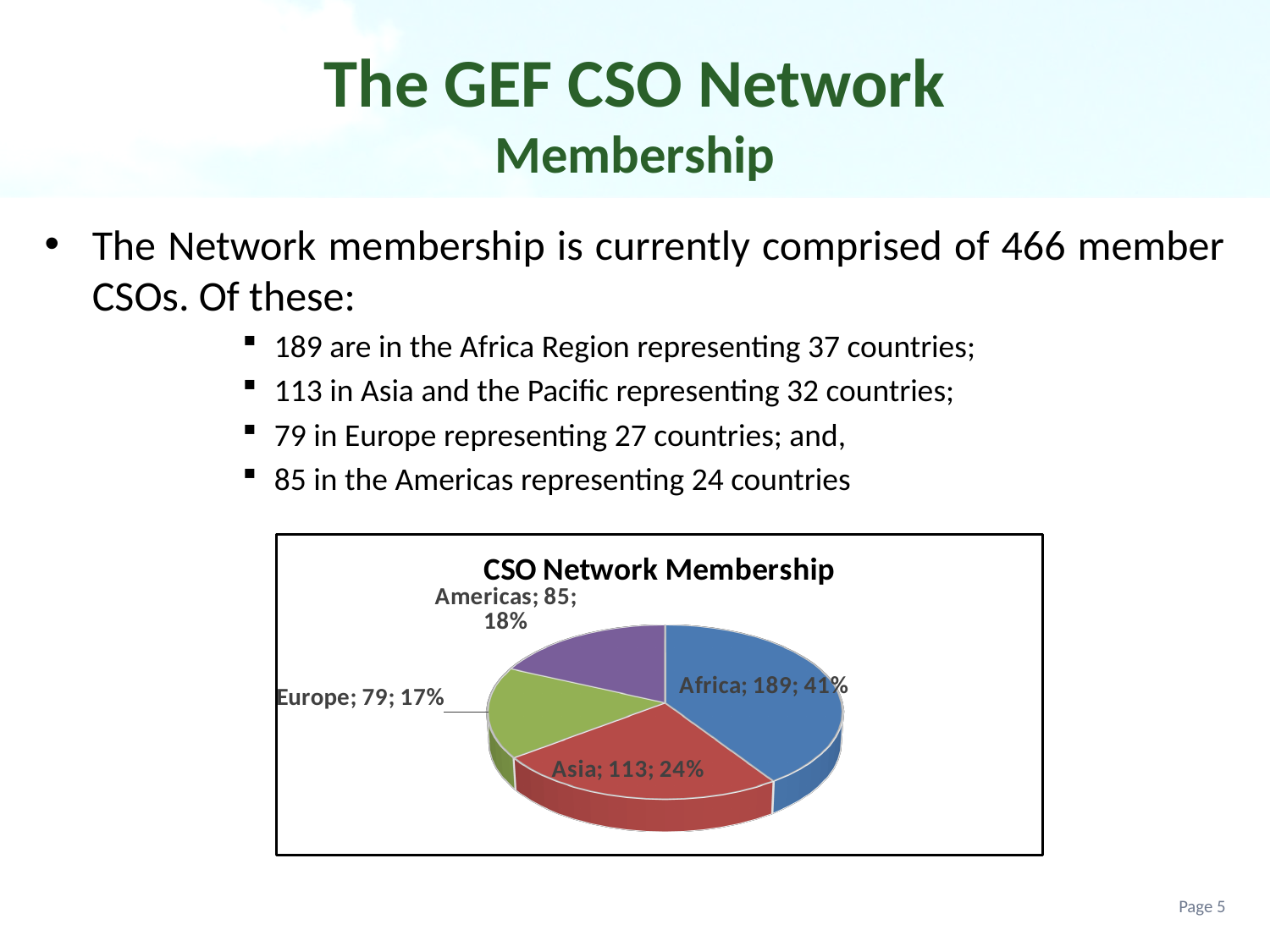
What is the value for Europe in the pie chart? 79 Which is larger, the value for the Americas or the value for Europe? Americas What share of the pie does Asia represent? 24% What is the value for the Americas in the pie chart? 85 What type of chart is shown on the slide? Pie chart What is the title of the chart? CSO Network Membership What is the value for Asia in the pie chart? 113 What is the value for Africa in the pie chart? 189 Which region has the largest slice of the pie chart? Africa Which region has the smallest slice of the pie chart? Europe What is the difference between the values for Africa and Asia? 76 How many slices does the pie chart have? 4